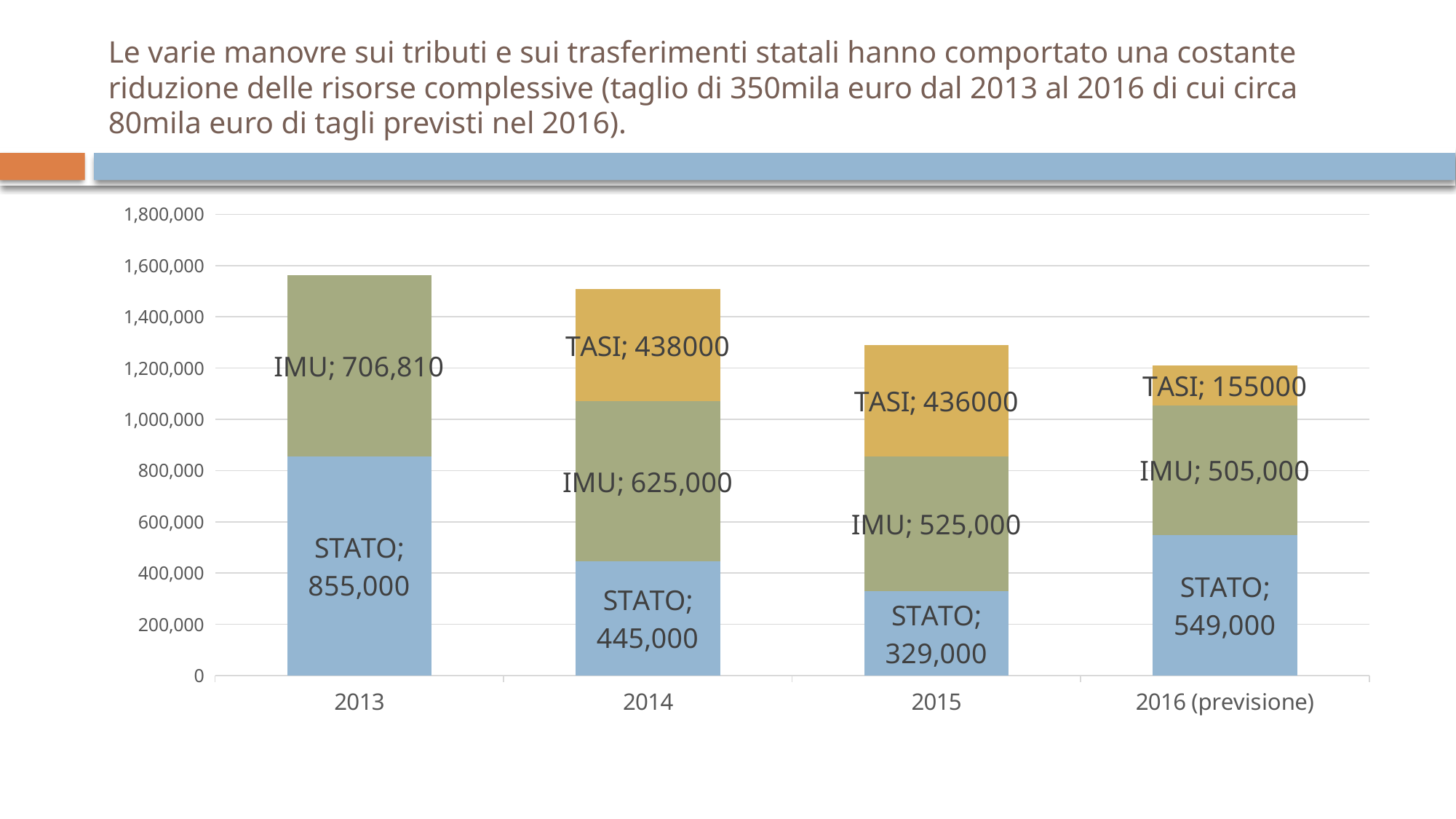
Which year has the larger TASI value, 2014 or 2016 (previsione)? 2014 What is the IMU value for 2016 (previsione)? 505,000 What is the STATO value for 2013? 855,000 What kind of chart is shown on the slide? Stacked bar chart Do the total bar heights rise or fall from 2013 to 2016 (previsione)? Fall What is the difference between the IMU value in 2014 and the IMU value in 2015? 100,000 In which year is the STATO value highest? 2013 In which year is the STATO value lowest? 2015 What is the IMU value for 2014? 625,000 How many years are shown on the x axis? 4 What is the total of the stacked bar for 2013? 1,561,810 What is the TASI value for 2015? 436000